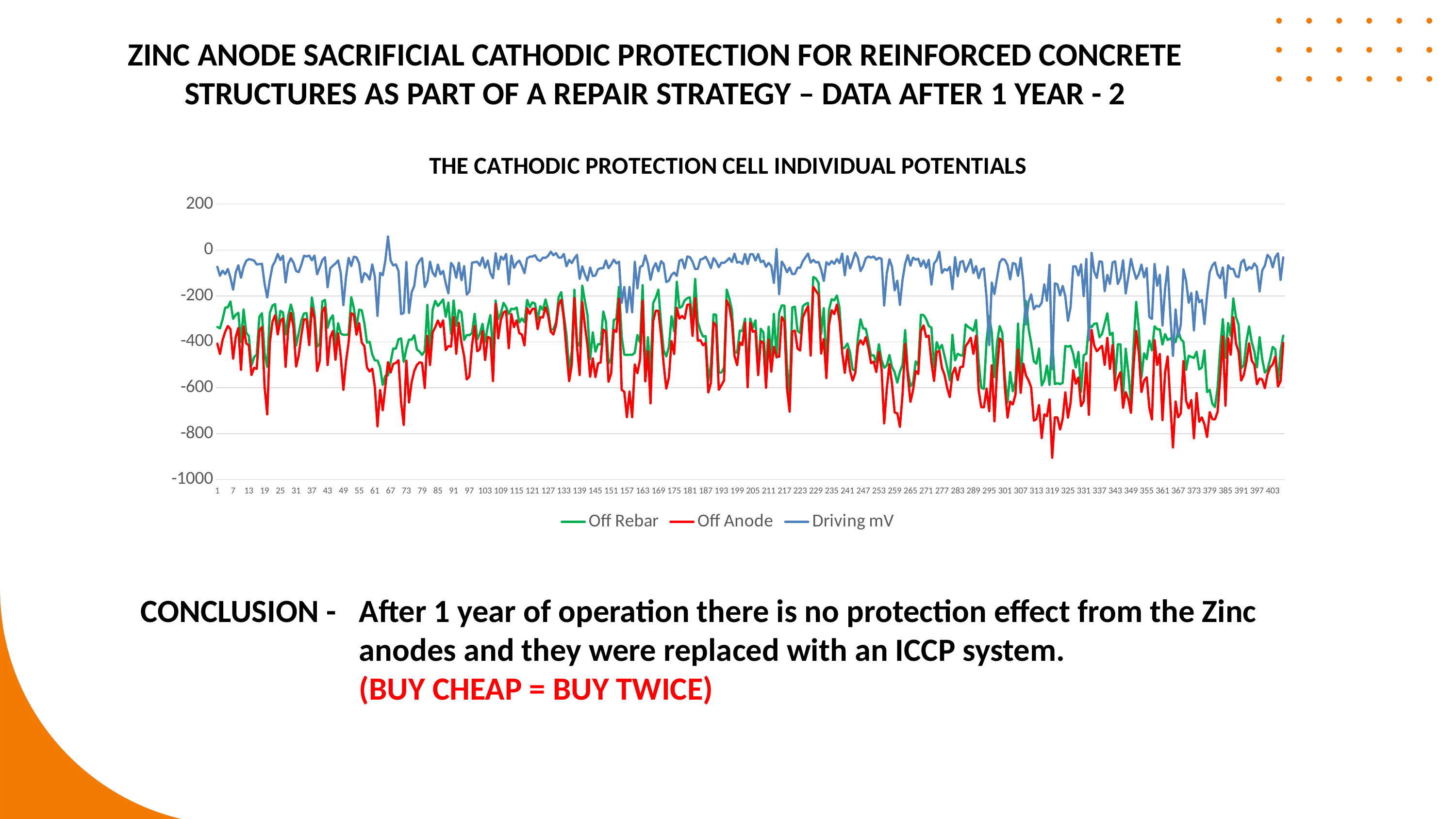
Which series generally has the highest values across the chart? Driving mV What kind of chart is shown on the slide? Line chart Is the lowest value of the Off Anode series greater or less than -800? less What is the lowest value shown on the vertical axis? -1000 What is the title of the chart? THE CATHODIC PROTECTION CELL INDIVIDUAL POTENTIALS Is the Driving mV series mostly above or below -200? above Is the lowest value of the Off Rebar series greater or less than -800? greater Which series is generally larger, Off Rebar or Off Anode? Off Rebar How many series does the chart legend list? 3 Which series generally has the lowest values across the chart? Off Anode Which colour is used for the Off Anode series? Red